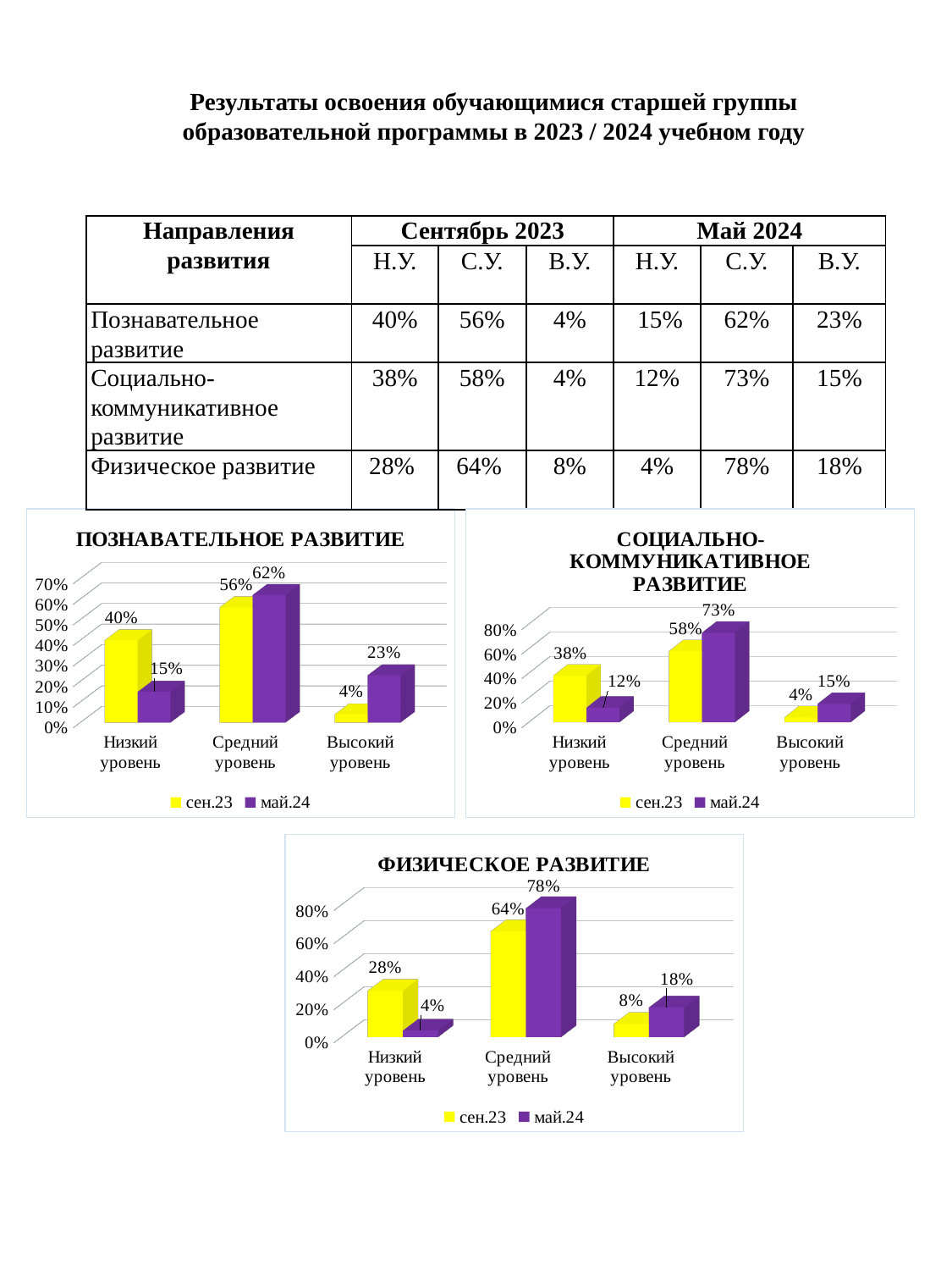
In the 'ФИЗИЧЕСКОЕ РАЗВИТИЕ' chart, what is the value for 'Средний уровень' in the 'май.24' series? 78% In the 'СОЦИАЛЬНО-КОММУНИКАТИВНОЕ РАЗВИТИЕ' chart, which category has the lowest 'сен.23' value? Высокий уровень In the 'СОЦИАЛЬНО-КОММУНИКАТИВНОЕ РАЗВИТИЕ' chart, what is the value for 'Средний уровень' in the 'май.24' series? 73% What kind of chart is the 'СОЦИАЛЬНО-КОММУНИКАТИВНОЕ РАЗВИТИЕ' chart? Bar chart In the 'ФИЗИЧЕСКОЕ РАЗВИТИЕ' chart, which category has the highest 'май.24' value? Средний уровень In the 'ПОЗНАВАТЕЛЬНОЕ РАЗВИТИЕ' chart, what is the difference between the 'сен.23' and 'май.24' values for 'Высокий уровень'? 19% How many series does the legend of the 'ФИЗИЧЕСКОЕ РАЗВИТИЕ' chart list? 2 In the 'СОЦИАЛЬНО-КОММУНИКАТИВНОЕ РАЗВИТИЕ' chart, which is larger for 'Низкий уровень': the 'сен.23' value or the 'май.24' value? сен.23 In the 'ФИЗИЧЕСКОЕ РАЗВИТИЕ' chart, what is the difference between the 'сен.23' and 'май.24' values for 'Низкий уровень'? 24% In the 'ПОЗНАВАТЕЛЬНОЕ РАЗВИТИЕ' chart, what is the value for 'Низкий уровень' in the 'сен.23' series? 40% How many categories are shown on the x axis of the 'ПОЗНАВАТЕЛЬНОЕ РАЗВИТИЕ' chart? 3 In the 'ПОЗНАВАТЕЛЬНОЕ РАЗВИТИЕ' chart, what is the value for 'Средний уровень' in the 'май.24' series? 62%